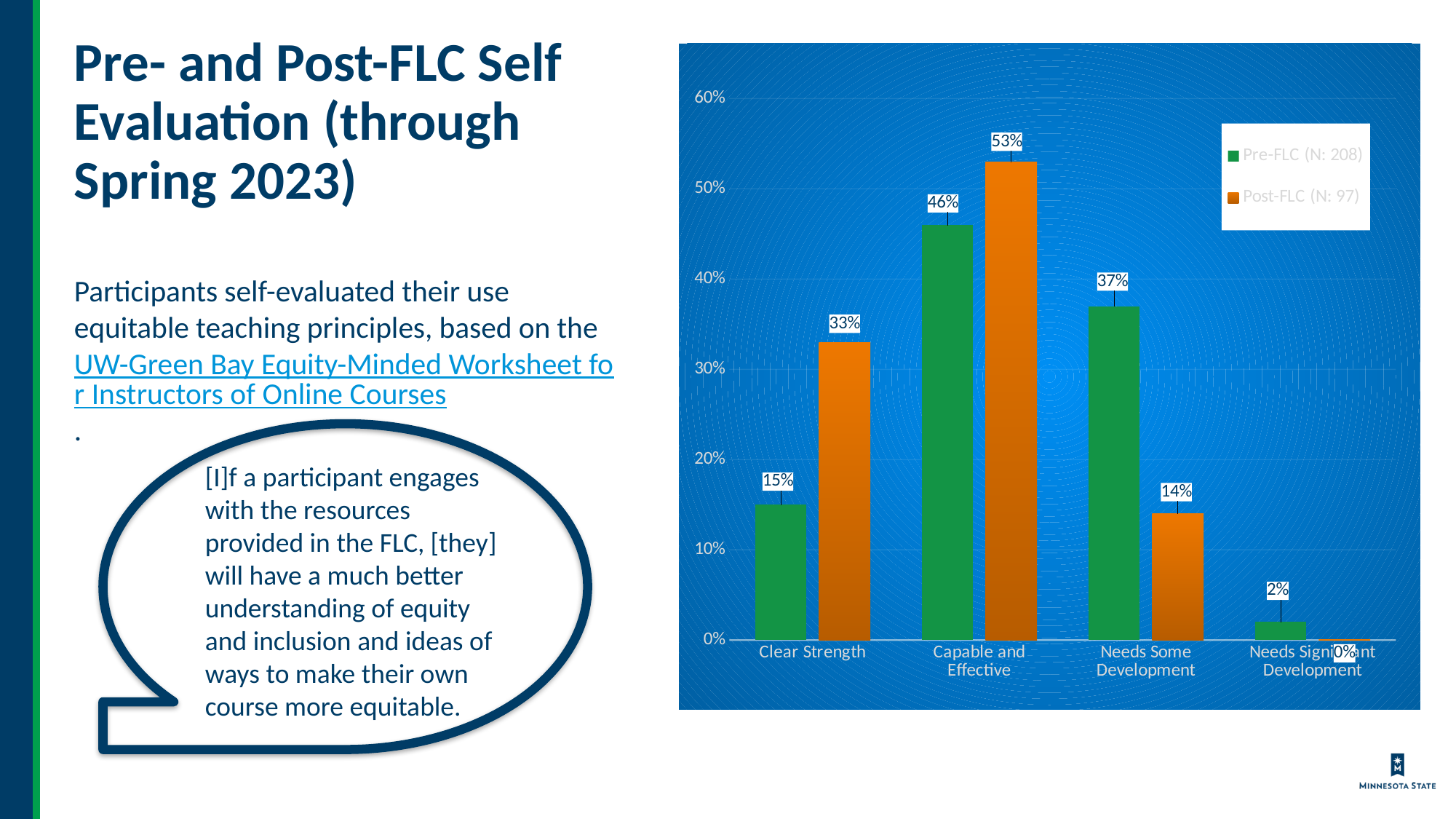
Which is larger for Clear Strength, the Pre-FLC value or the Post-FLC value? Post-FLC Which category has the lowest Post-FLC value? Needs Significant Development What is the difference between the Post-FLC and Pre-FLC values for Needs Some Development? 23% Which category has the highest Pre-FLC value? Capable and Effective What is the Post-FLC value for Capable and Effective? 53% What is the Post-FLC value for Needs Significant Development? 0% What kind of chart is shown on the slide? Bar chart How many series does the legend list? 2 What is the Pre-FLC value for Needs Some Development? 37% What is the Post-FLC value for Clear Strength? 33% What is the Pre-FLC value for Clear Strength? 15% How many categories are shown on the x axis? 4